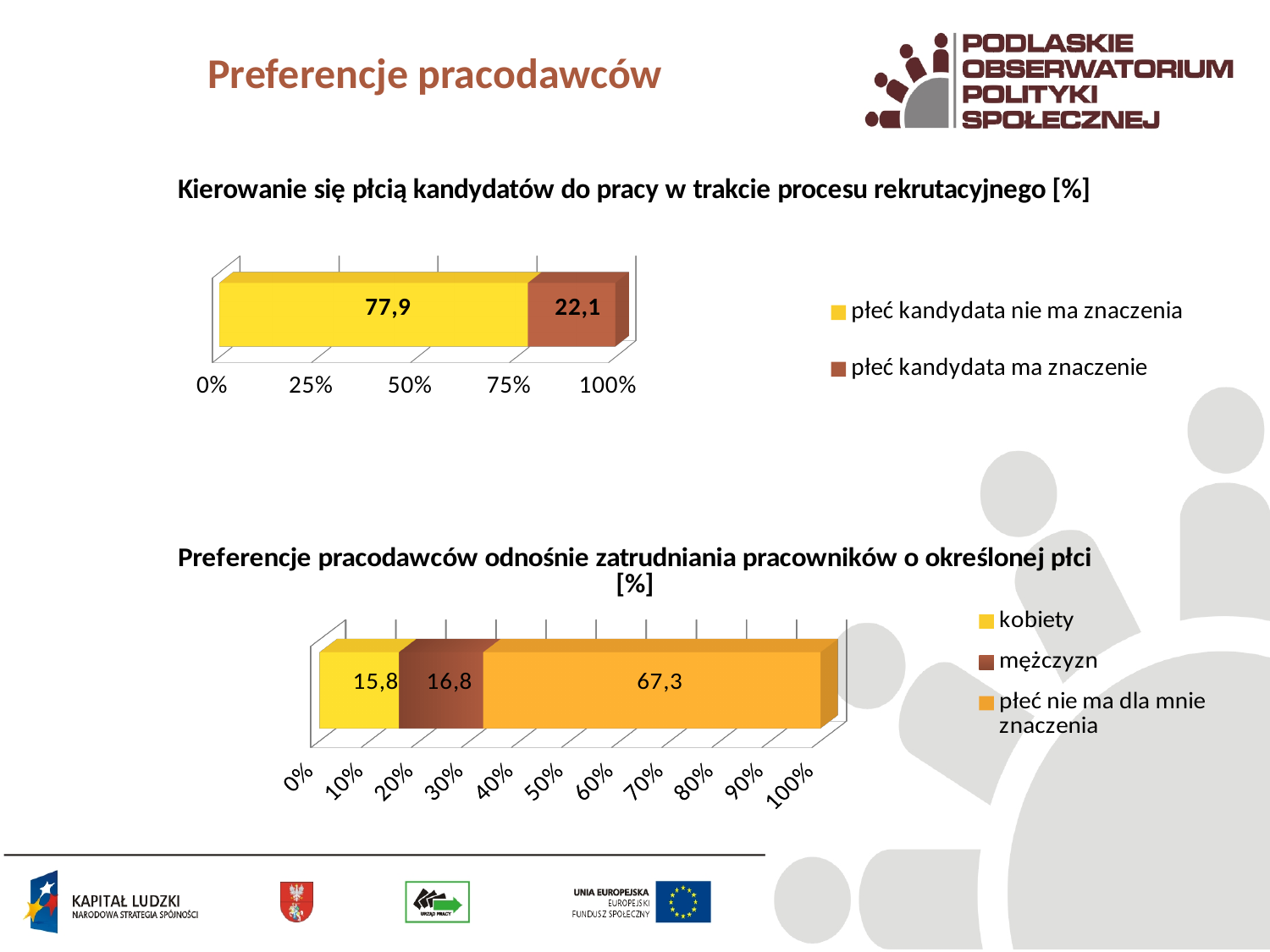
In the bottom chart (Preferencje pracodawców odnośnie zatrudniania pracowników o określonej płci), what is the value for 'kobiety'? 15,8 In the bottom chart (Preferencje pracodawców odnośnie zatrudniania pracowników o określonej płci), what is the value for 'mężczyzn'? 16,8 In the bottom chart, how many series does the legend list? 3 In the top chart, how many series does the legend list? 2 In the top chart (Kierowanie się płcią kandydatów do pracy w trakcie procesu rekrutacyjnego), what is the value for 'płeć kandydata nie ma znaczenia'? 77,9 In the bottom chart, what is the value for 'płeć nie ma dla mnie znaczenia'? 67,3 What kind of chart is the top chart on the slide? Stacked bar chart In the top chart, what is the difference between the values for 'płeć kandydata nie ma znaczenia' and 'płeć kandydata ma znaczenie'? 55,8 In the bottom chart, what is the difference between the values for 'mężczyzn' and 'kobiety'? 1,0 In the bottom chart, which series has the lowest value? kobiety In the top chart (Kierowanie się płcią kandydatów do pracy w trakcie procesu rekrutacyjnego), what is the value for 'płeć kandydata ma znaczenie'? 22,1 In the bottom chart, which series has the highest value? płeć nie ma dla mnie znaczenia